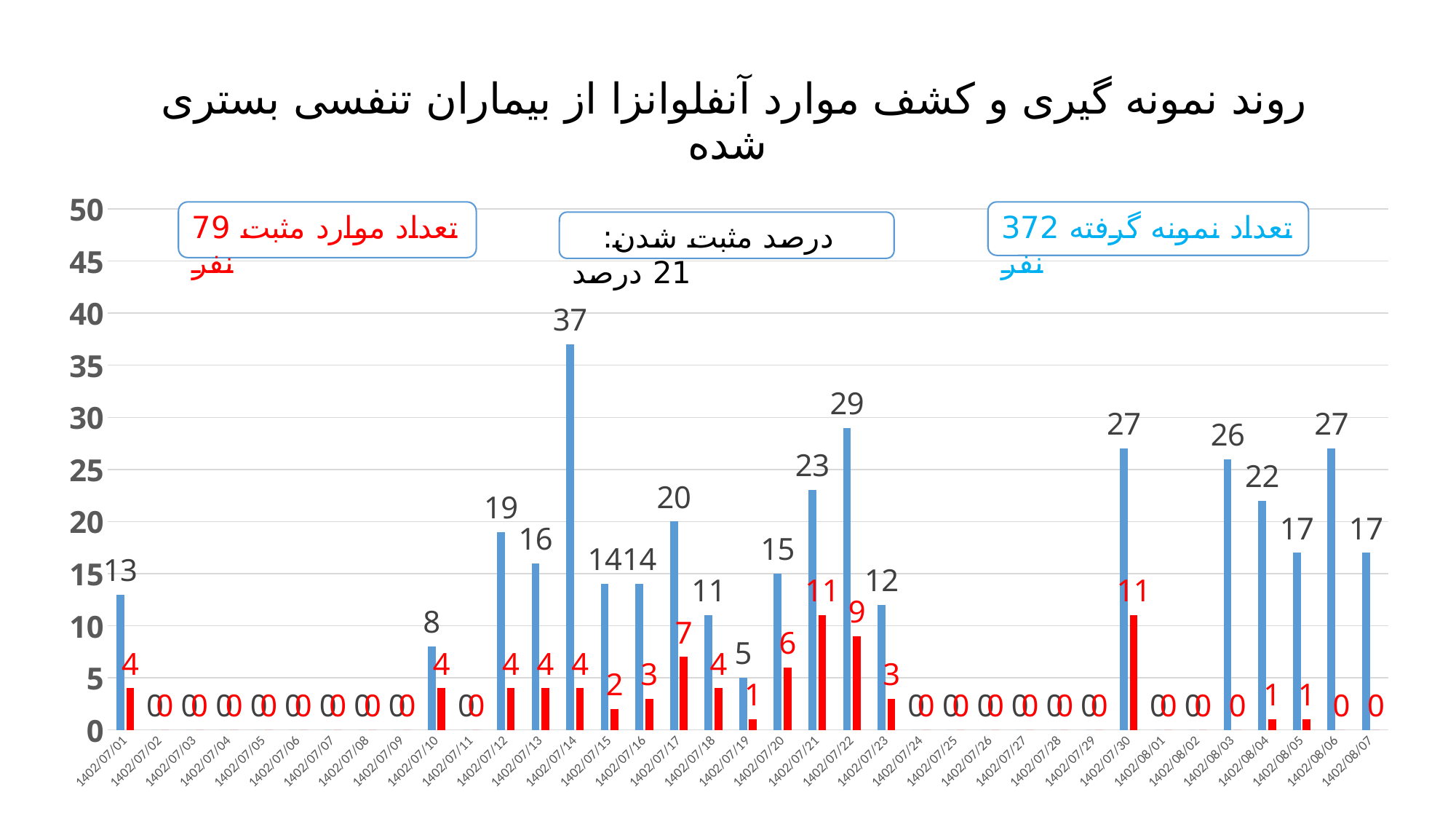
What is the value of the blue bar for 1402/07/30? 27 Is the blue bar for 1402/07/14 greater or less than 35? greater What is the value of the red bar for 1402/07/21? 11 On which date is the blue bar highest? 1402/07/14 What kind of chart is shown on the slide? bar chart What total number of positive cases is stated in the red text box on the slide? 79 What is the value of the blue bar for 1402/07/14? 37 What is the difference between the blue bar values on 1402/07/14 and 1402/07/22? 8 What is the difference between the blue bar and the red bar on 1402/07/22? 20 Which date has the larger blue bar, 1402/07/21 or 1402/07/22? 1402/07/22 How many dates are shown on the x axis? 37 What total number of samples taken is stated in the blue text box on the slide? 372